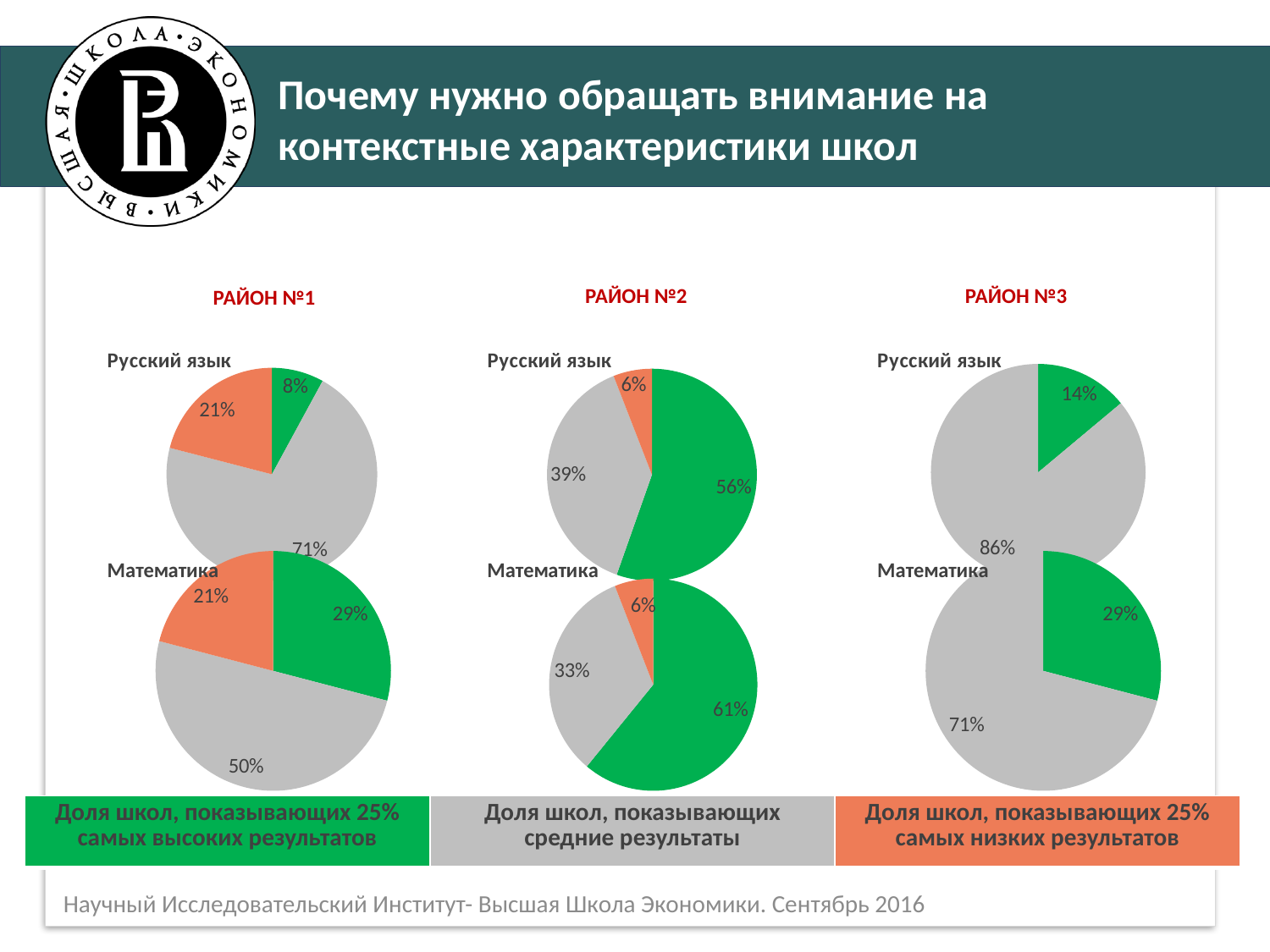
Which is larger: the share of schools with the 25% highest results in Район №2 Русский язык or in Район №3 Русский язык? Район №2 Русский язык In the Район №2 Русский язык pie chart, what share of schools show the 25% lowest results? 6% In the Район №1 Математика pie chart, what is the difference between the share of schools with average results and the share with the 25% lowest results? 29% In the Район №1 Русский язык pie chart, what share of schools show the 25% highest results? 8% In the Район №1 Математика pie chart, what share of schools show average results? 50% In the Район №3 Русский язык pie chart, what share of schools show average results? 86% Which colour represents the share of schools showing the 25% lowest results? Orange In the Район №2 Математика pie chart, what share of schools show the 25% highest results? 61% How many pie charts are shown on the slide? 6 What type of chart is used to show the results for each district? Pie chart In the Район №3 Математика pie chart, which category has the largest slice? Доля школ, показывающих средние результаты In the Район №2 Математика pie chart, which category has the smallest slice? Доля школ, показывающих 25% самых низких результатов